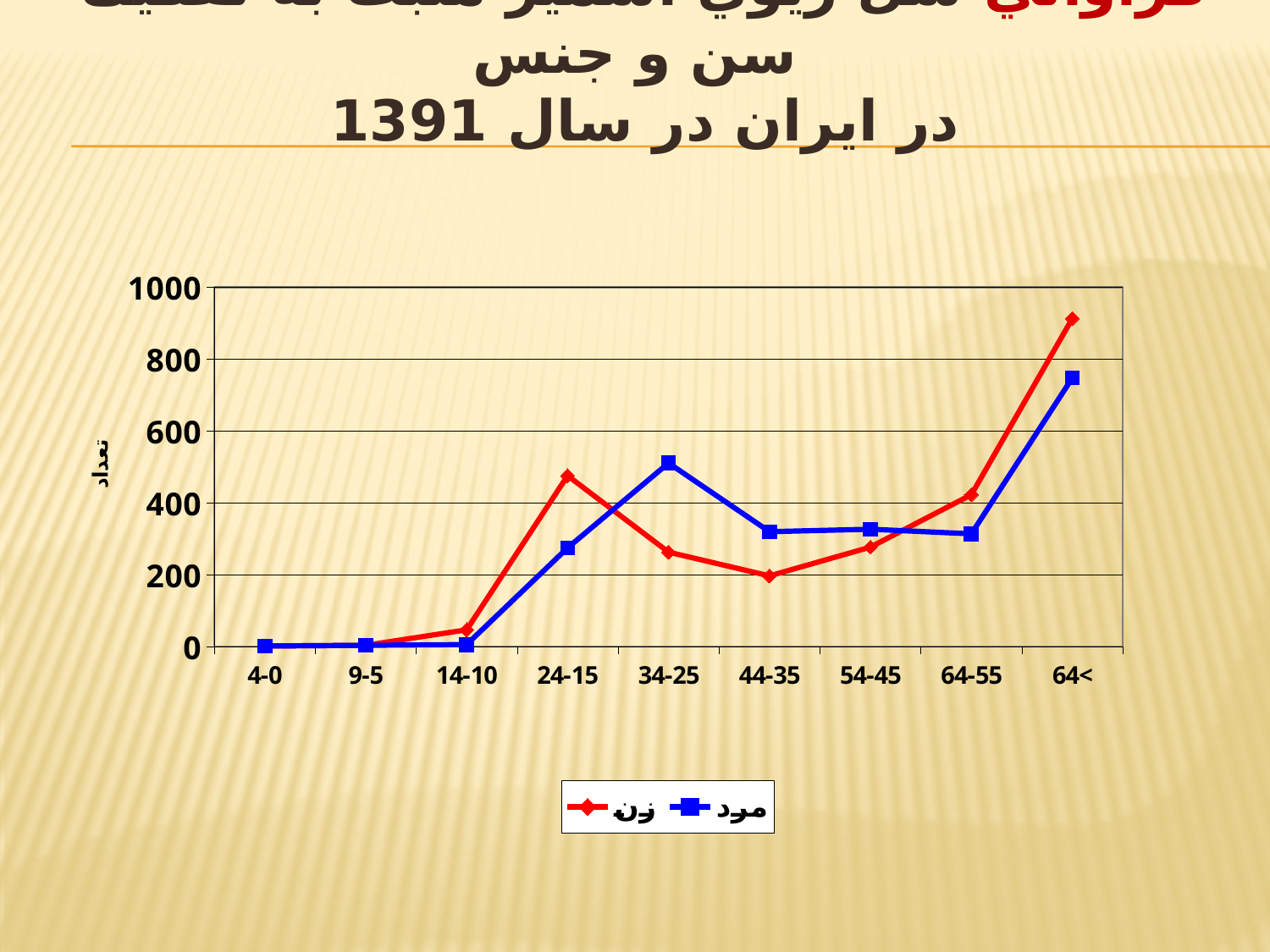
In the 34-25 category, which series has the larger value, زن or مرد? مرد Is the value for زن in the 64< category greater or less than 800? greater What kind of chart is shown on the slide? line chart Is the value for زن in the 44-35 category greater or less than 400? less What is the label on the y axis? تعداد For which age category is the value for مرد highest? 64< Do the values for مرد rise or fall from the 64-55 category to the 64< category? rise For which age category is the value for زن highest? 64< In the 24-15 category, which series has the larger value, زن or مرد? زن How many age categories are shown on the x axis? 9 Is the value for مرد in the 34-25 category greater or less than 400? greater How many series does the legend list? 2